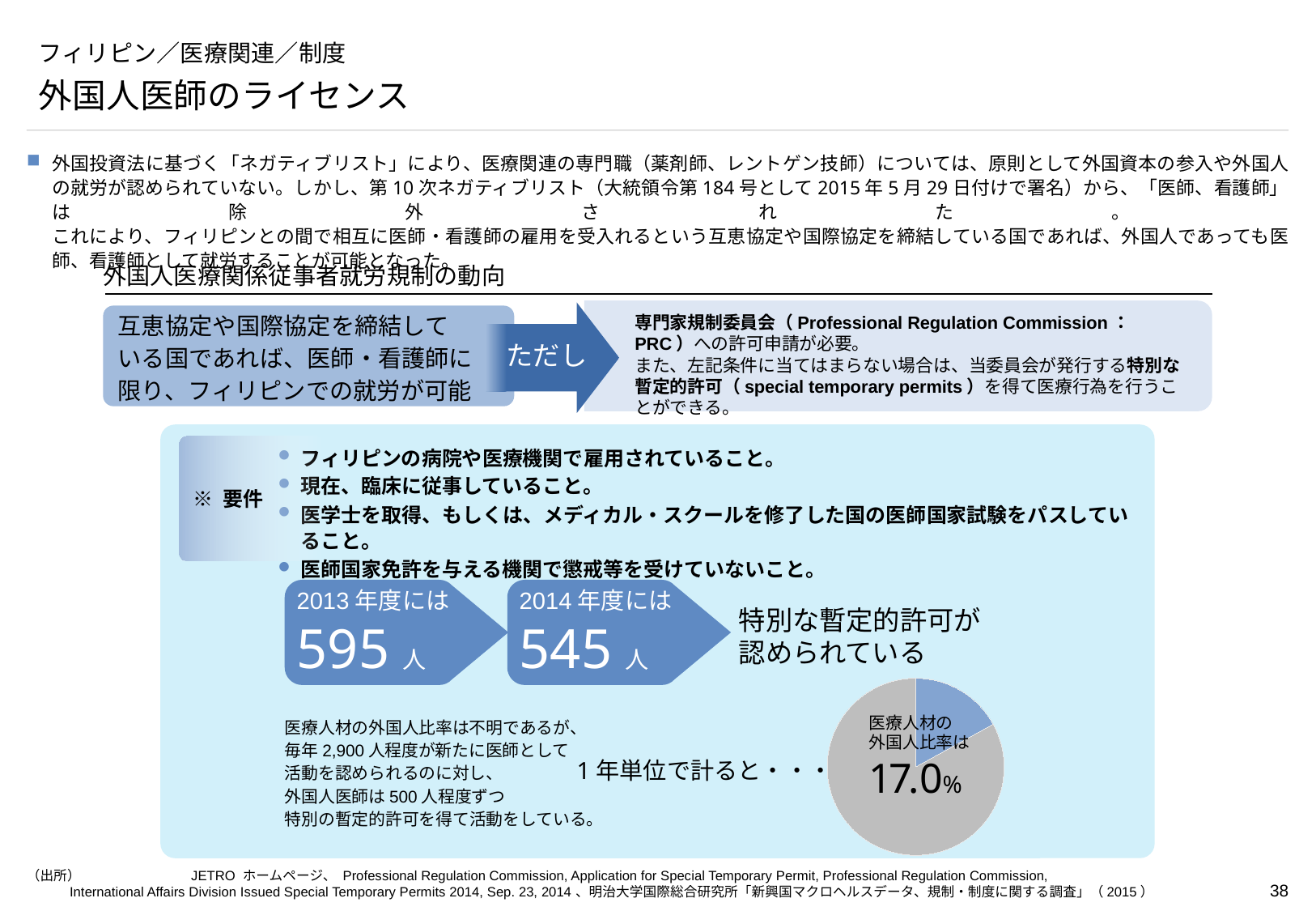
In the pie chart, what share is shown for 医療人材の外国人比率 (the foreign ratio of medical personnel)? 17.0% What kind of chart is shown at the bottom right of the slide? pie chart Is the share shown in the pie chart greater or less than 20%? less What share of the pie chart does the blue slice represent? 17.0% What colour is the slice labelled 17.0% in the pie chart? blue How many slices does the pie chart have? 2 In the pie chart, which slice is larger: the blue slice or the gray slice? the gray slice What label is written inside the pie chart above the 17.0% value? 医療人材の外国人比率は